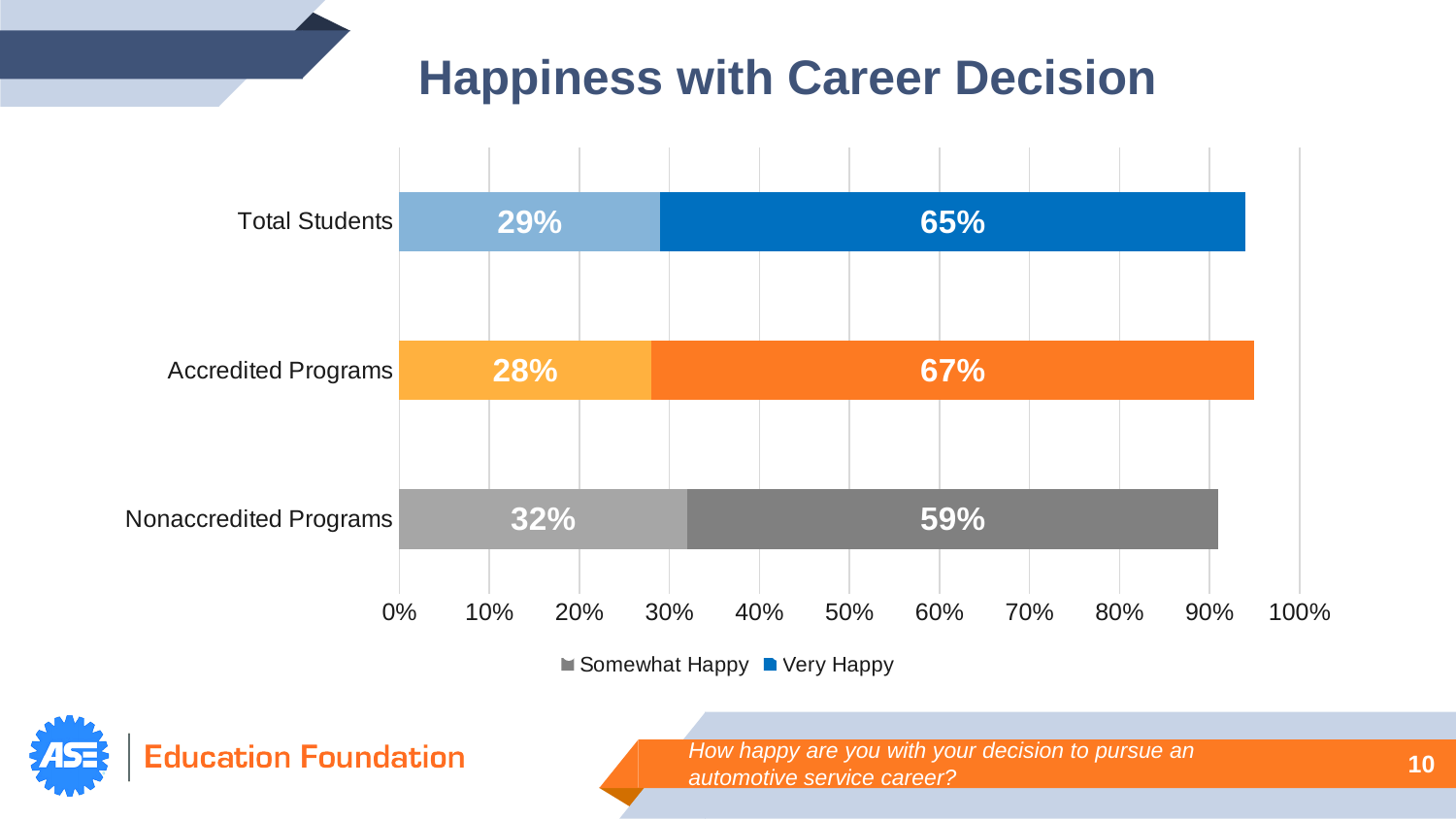
What is the difference between the Very Happy percentages for Accredited Programs and Nonaccredited Programs? 8% How many categories are shown on the chart? 3 Which category has the lowest Somewhat Happy percentage? Accredited Programs How many series does the legend list? 2 What is the combined Somewhat Happy and Very Happy percentage for Total Students? 94% Which category has the highest Very Happy percentage? Accredited Programs What percentage of Total Students are Very Happy with their career decision? 65% What is the combined Somewhat Happy and Very Happy percentage for Nonaccredited Programs? 91% Which is larger: the Somewhat Happy percentage for Nonaccredited Programs or for Total Students? Nonaccredited Programs What percentage of students in Accredited Programs are Somewhat Happy? 28% What type of chart is shown on the slide? Stacked bar chart What percentage of students in Nonaccredited Programs are Very Happy? 59%